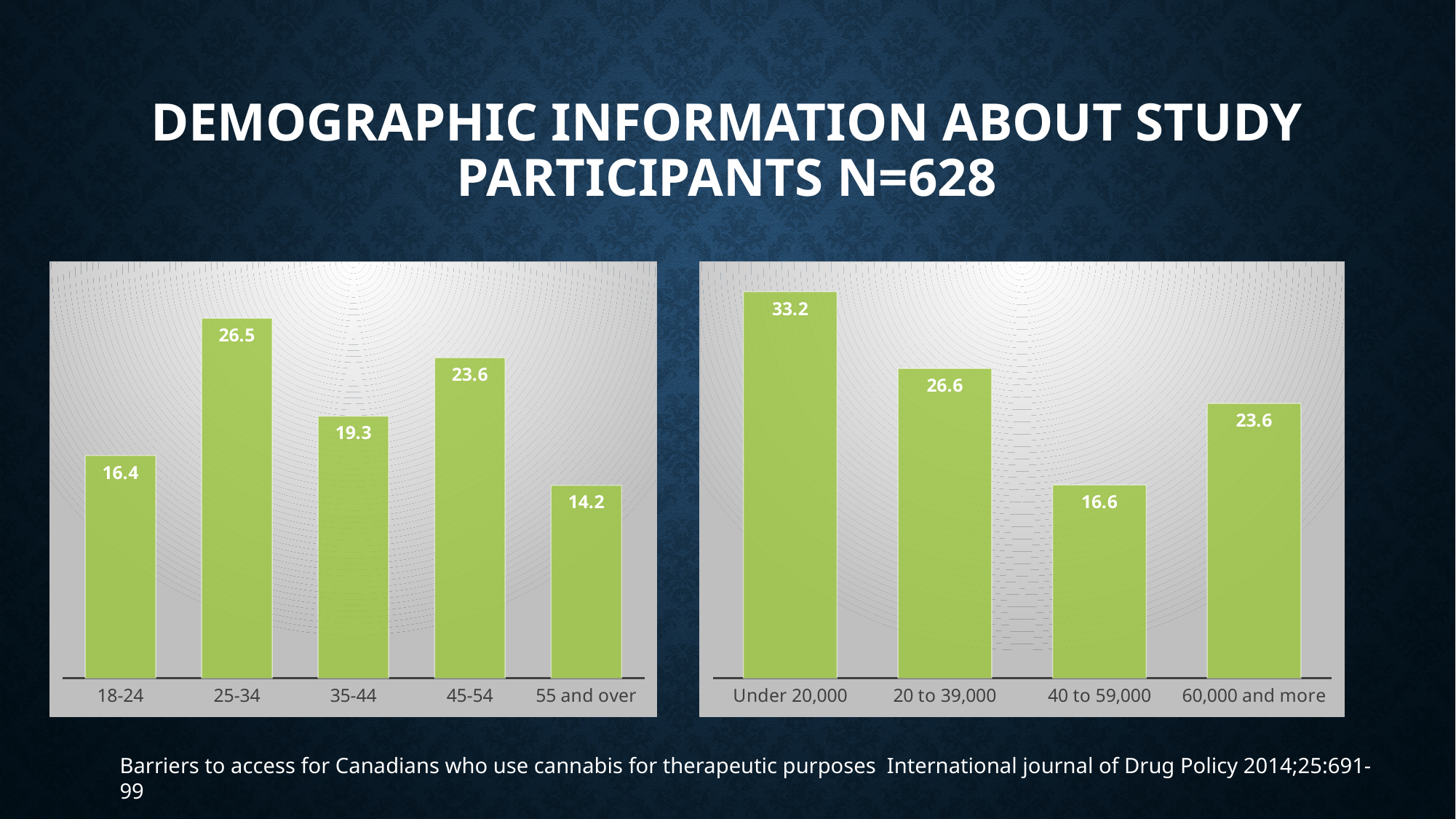
In the left chart (age groups), which category has the lowest value? 55 and over In the left chart (age groups), what is the value for the 25-34 category? 26.5 In the left chart (age groups), which category has the highest value? 25-34 What type of chart is the right chart (income groups)? bar chart In the right chart (income groups), which is larger, the value for 20 to 39,000 or the value for 60,000 and more? 20 to 39,000 In the right chart (income groups), what is the value for Under 20,000? 33.2 In the left chart (age groups), what is the difference between the values for 25-34 and 18-24? 10.1 In the right chart (income groups), which category has the lowest value? 40 to 59,000 In the left chart (age groups), how many categories are shown? 5 In the right chart (income groups), what is the difference between the values for Under 20,000 and 40 to 59,000? 16.6 In the right chart (income groups), how many categories are shown? 4 In the left chart (age groups), do the values rise or fall from 45-54 to 55 and over? fall